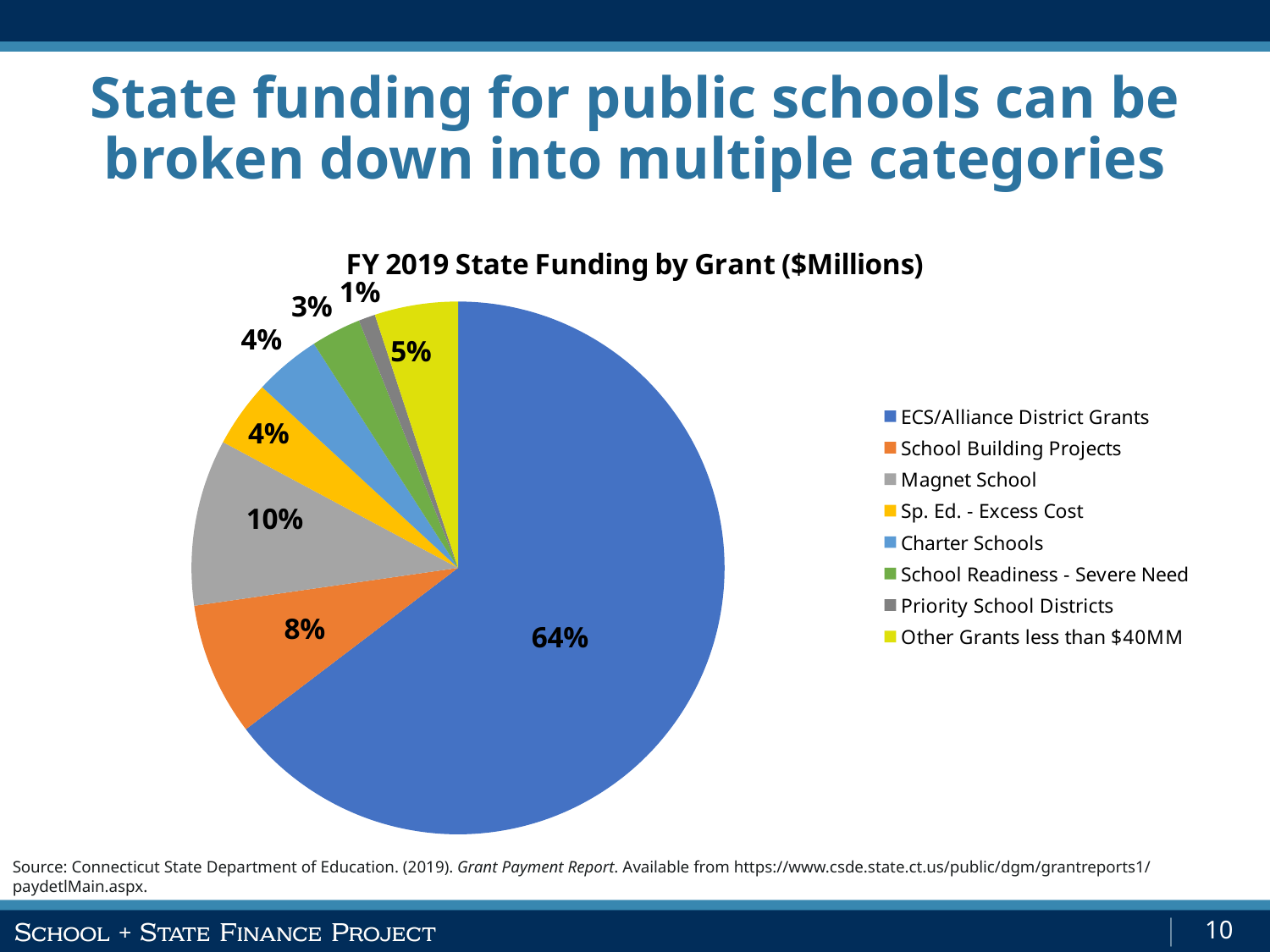
What type of chart is shown on the slide? Pie chart How many percentage points larger is the Magnet School share than the School Building Projects share? 2 What percentage is shown for School Readiness - Severe Need? 3% What percentage is shown for Other Grants less than $40MM? 5% How many grant categories does the legend list? 8 Which grant category has the smallest share of the pie? Priority School Districts Which is larger, the share for Magnet School or the share for Other Grants less than $40MM? Magnet School What share of FY 2019 state funding goes to ECS/Alliance District Grants? 64% Which grant category has the largest share of FY 2019 state funding? ECS/Alliance District Grants